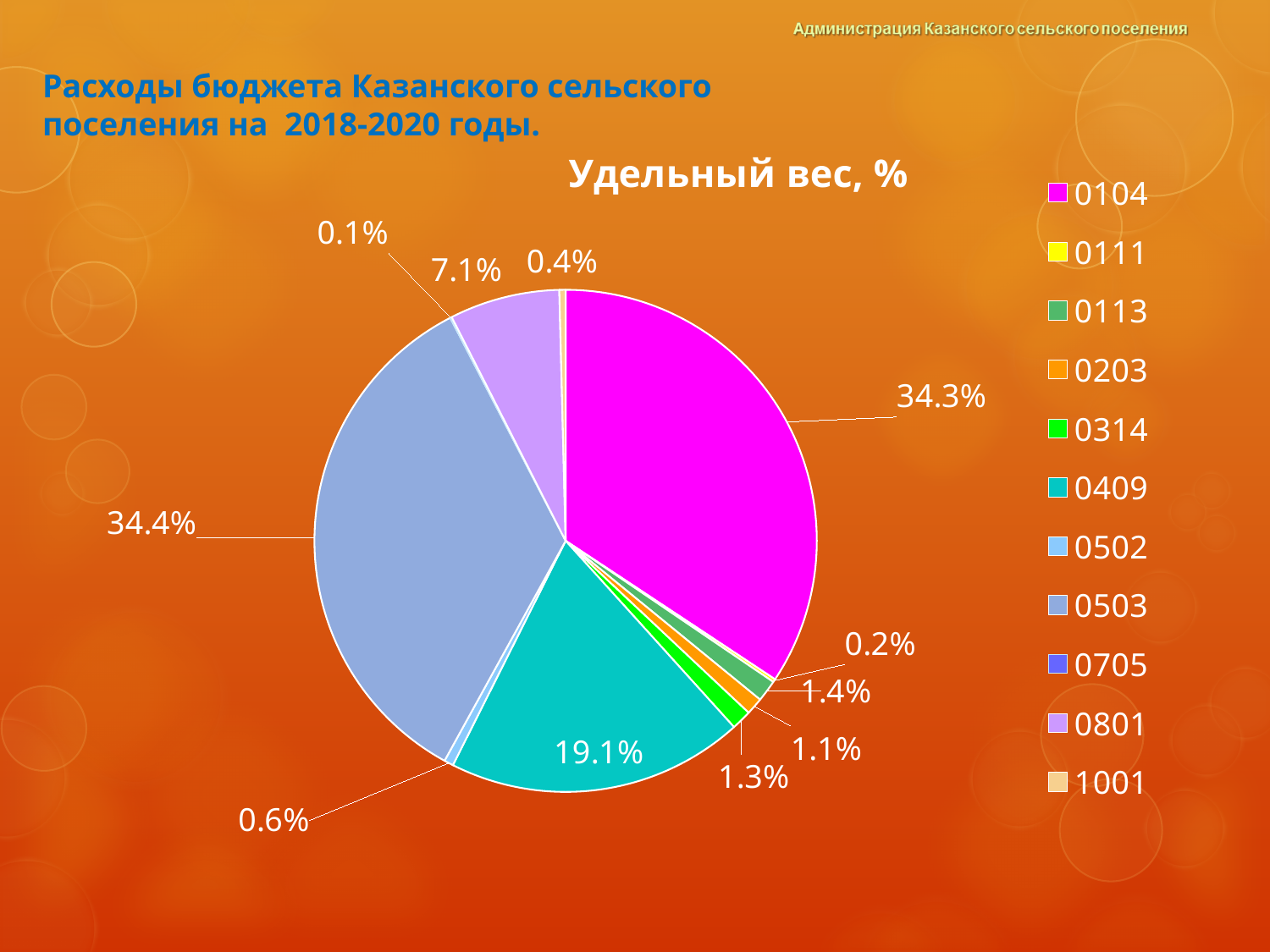
Which has a larger share, 0113 or 0203? 0113 Which category has the smallest share of the pie? 0705 What share of the pie does category 0503 have? 34.4% What share of the pie does category 0502 have? 0.6% Which category has the largest share of the pie? 0503 What type of chart is shown on the slide? Pie chart What is the title of the chart? Удельный вес, % What share of the pie does category 0801 have? 7.1% What share of the pie does category 0104 have? 34.3% How many categories are shown in the pie chart? 11 What share of the pie does category 0409 have? 19.1% What is the difference between the shares of 0104 and 0409? 15.2%